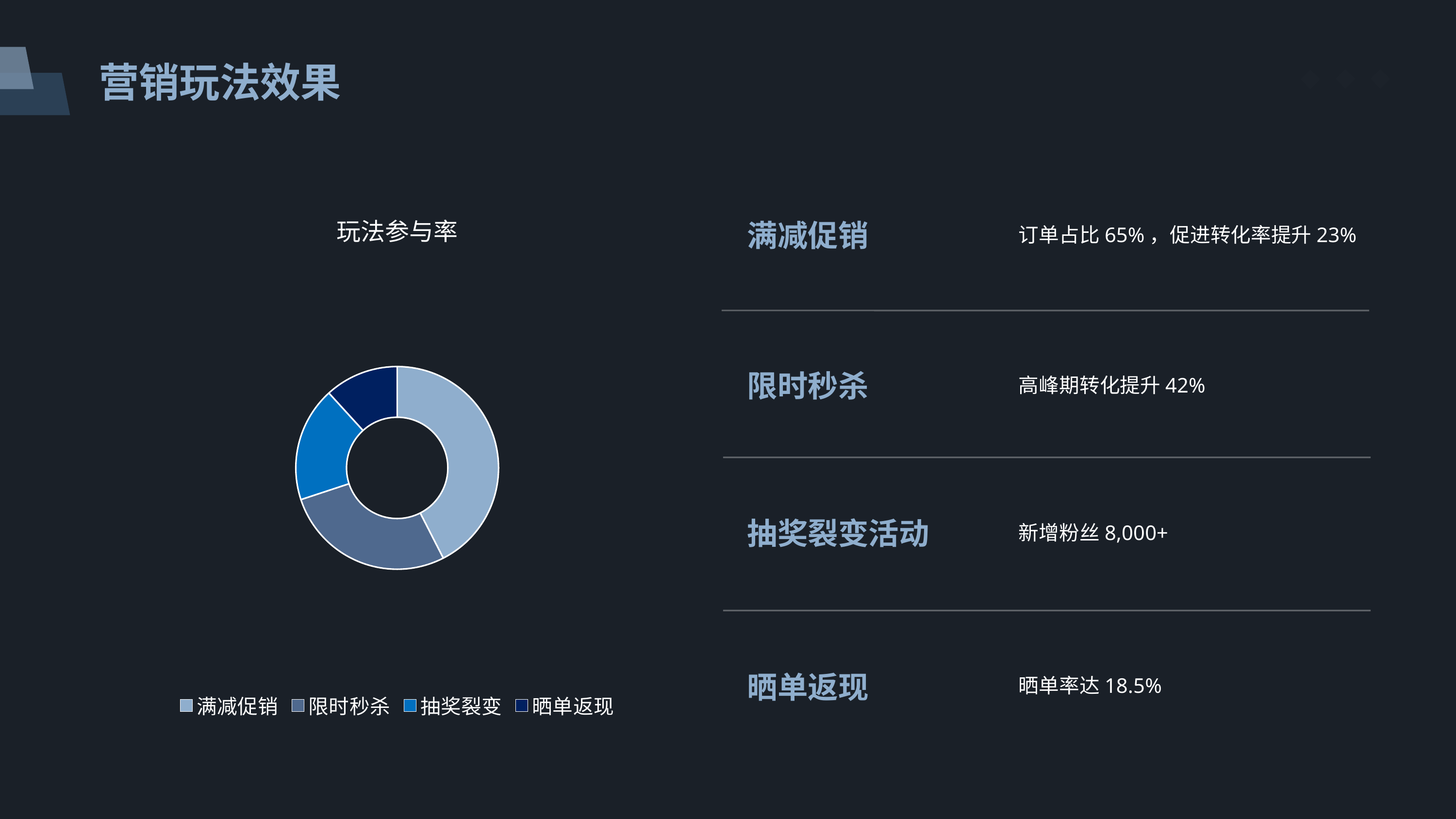
Which slice is larger, 限时秒杀 or 晒单返现? 限时秒杀 Which category has the largest slice in the doughnut chart? 满减促销 How many entries does the chart legend list? 4 What is the title of the chart on the slide? 玩法参与率 How many categories does the doughnut chart show? 4 What kind of chart is shown on the slide? doughnut chart Which slice is larger, 满减促销 or 限时秒杀? 满减促销 Which legend entry is shown with the lightest blue colour? 满减促销 Which slice is larger, 限时秒杀 or 抽奖裂变? 限时秒杀